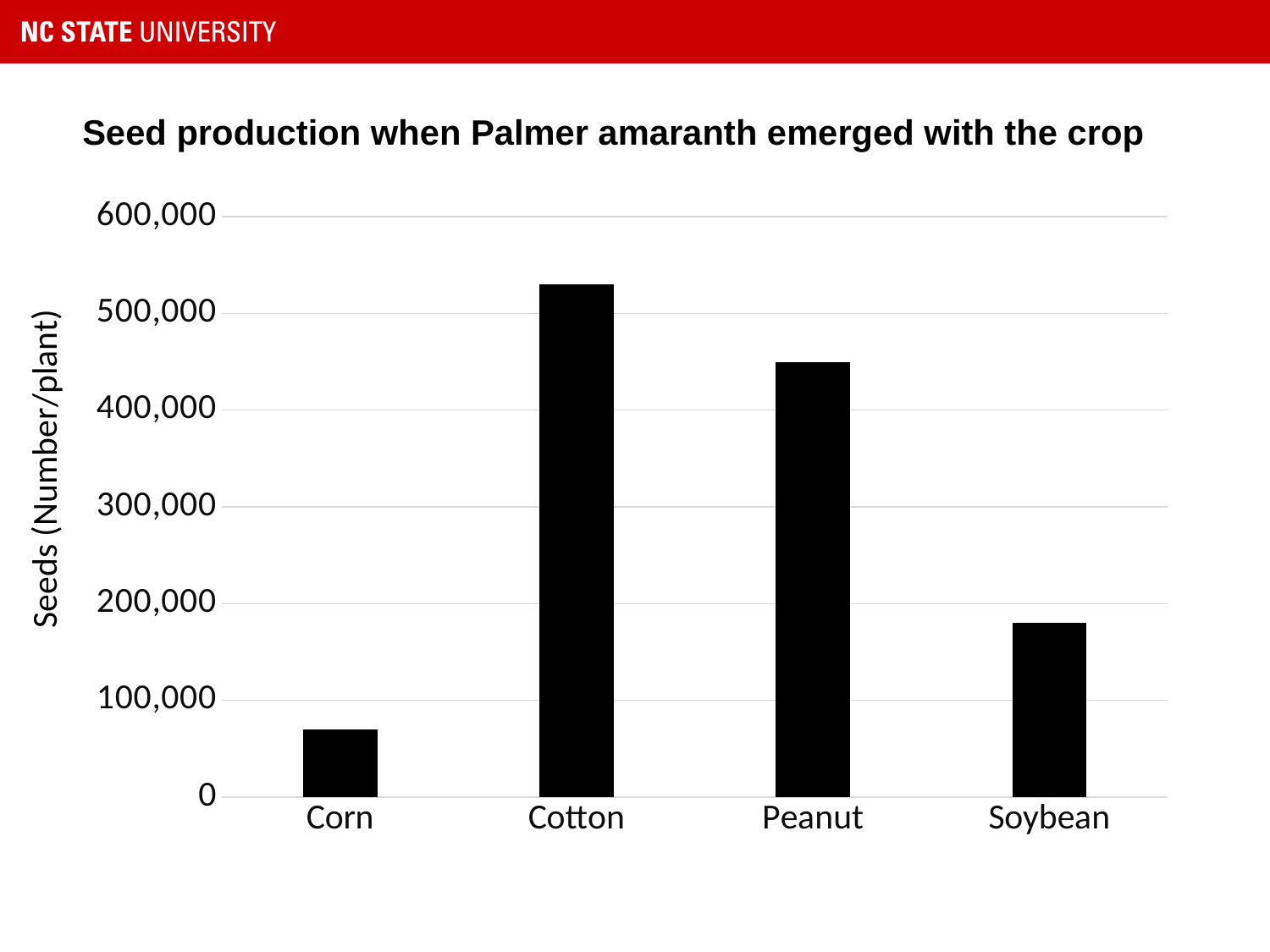
What is the title of the chart? Seed production when Palmer amaranth emerged with the crop Which has a higher seed production, Corn or Soybean? Soybean Is the value for Cotton greater or less than 500,000? greater What is the label of the y axis? Seeds (Number/plant) Which crop has the highest Palmer amaranth seed production? Cotton Is the value for Soybean greater or less than 200,000? less Is the value for Corn greater or less than 100,000? less What type of chart is shown on the slide? bar chart Which crop has the lowest Palmer amaranth seed production? Corn How many crops are shown on the x axis? 4 Which has a higher seed production, Peanut or Soybean? Peanut